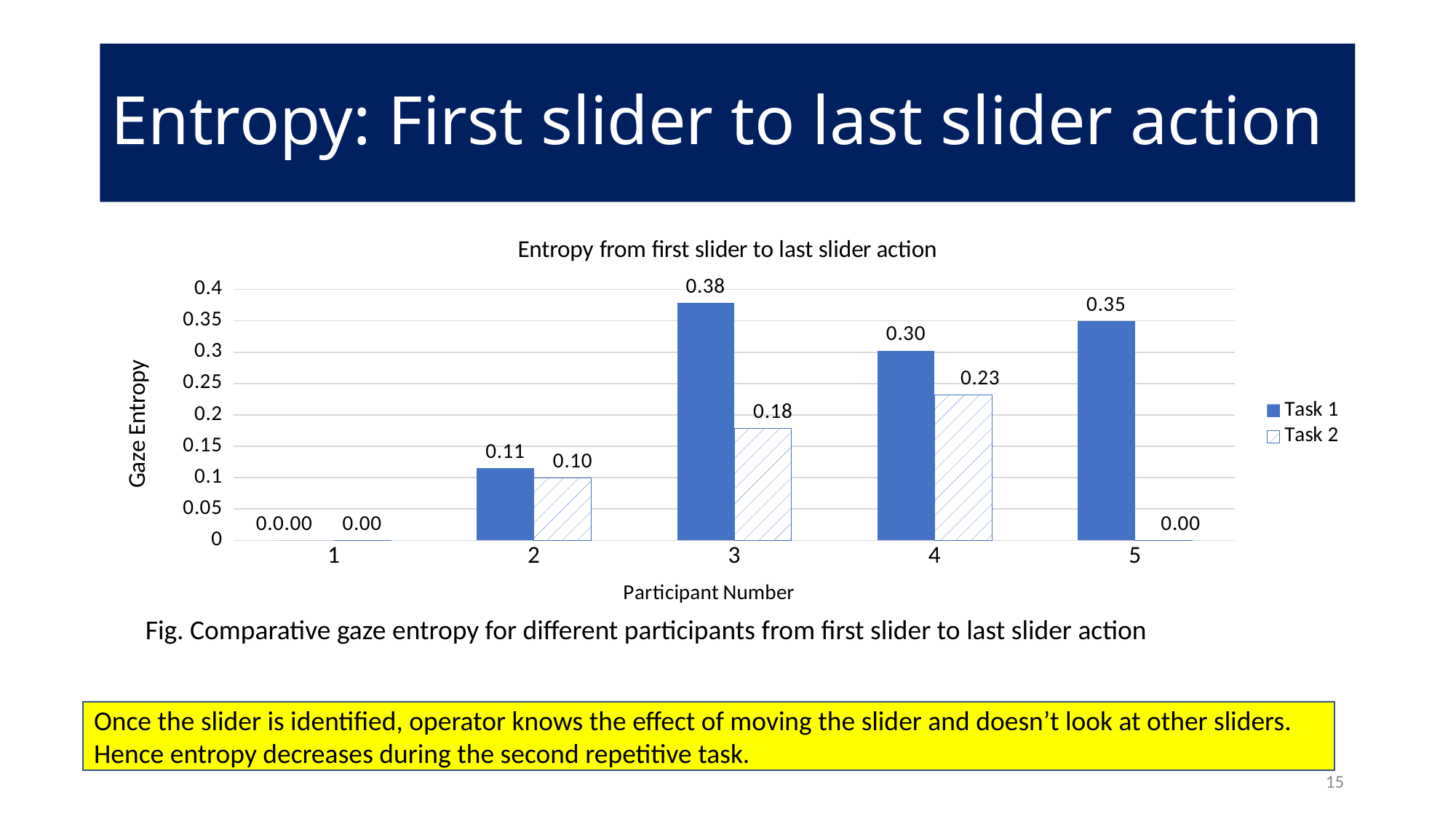
How many participants are shown on the x axis? 5 What is the difference between the Task 1 and Task 2 values for participant 3? 0.20 Which is larger for participant 4: the Task 1 value or the Task 2 value? Task 1 What is the Task 1 gaze entropy value for participant 3? 0.38 What is the Task 2 gaze entropy value for participant 4? 0.23 How many series does the legend list? 2 Which participant has the highest Task 2 gaze entropy? 4 Is the Task 1 value for participant 5 greater or less than 0.3? greater What is the difference between the Task 1 values for participant 3 and participant 5? 0.03 Which participant has the highest Task 1 gaze entropy? 3 What is the Task 2 value for participant 5? 0.00 What type of chart is shown on the slide? Bar chart